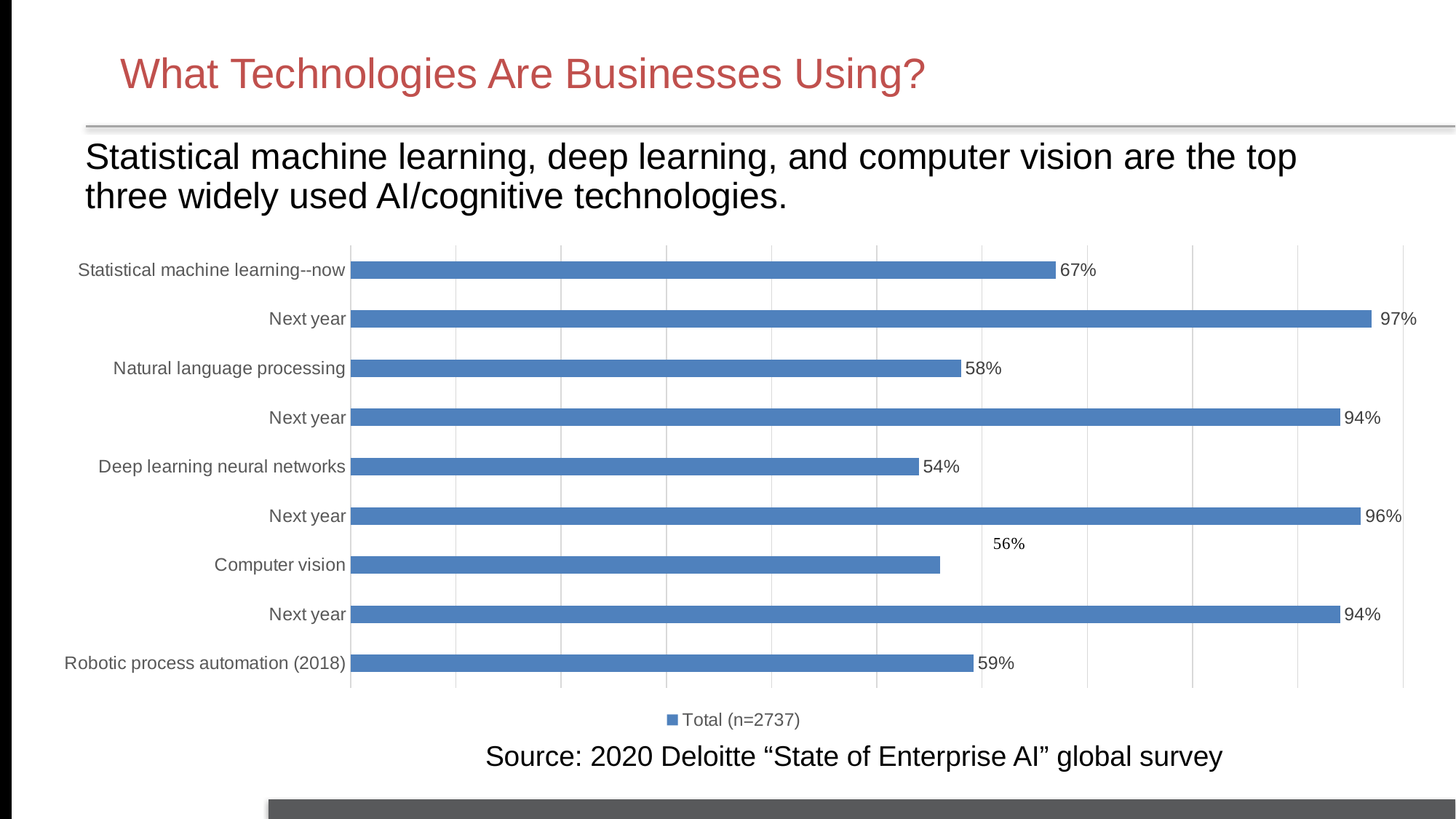
What is the value for Natural language processing? 58% What is the value for Computer vision? 56% What is the value of the Next year bar directly below Statistical machine learning--now? 97% What type of chart is shown on the slide? bar chart What is the value for Deep learning neural networks? 54% How many bars are plotted in the chart? 9 Which category has the lowest value in the chart? Deep learning neural networks What is the difference between the value for Statistical machine learning--now and the Next year bar directly below it? 30% What is the value for Robotic process automation (2018)? 59% Which is larger, the value for Natural language processing or the value for Computer vision? Natural language processing What is the highest value shown in the chart? 97% What is the value for Statistical machine learning--now? 67%